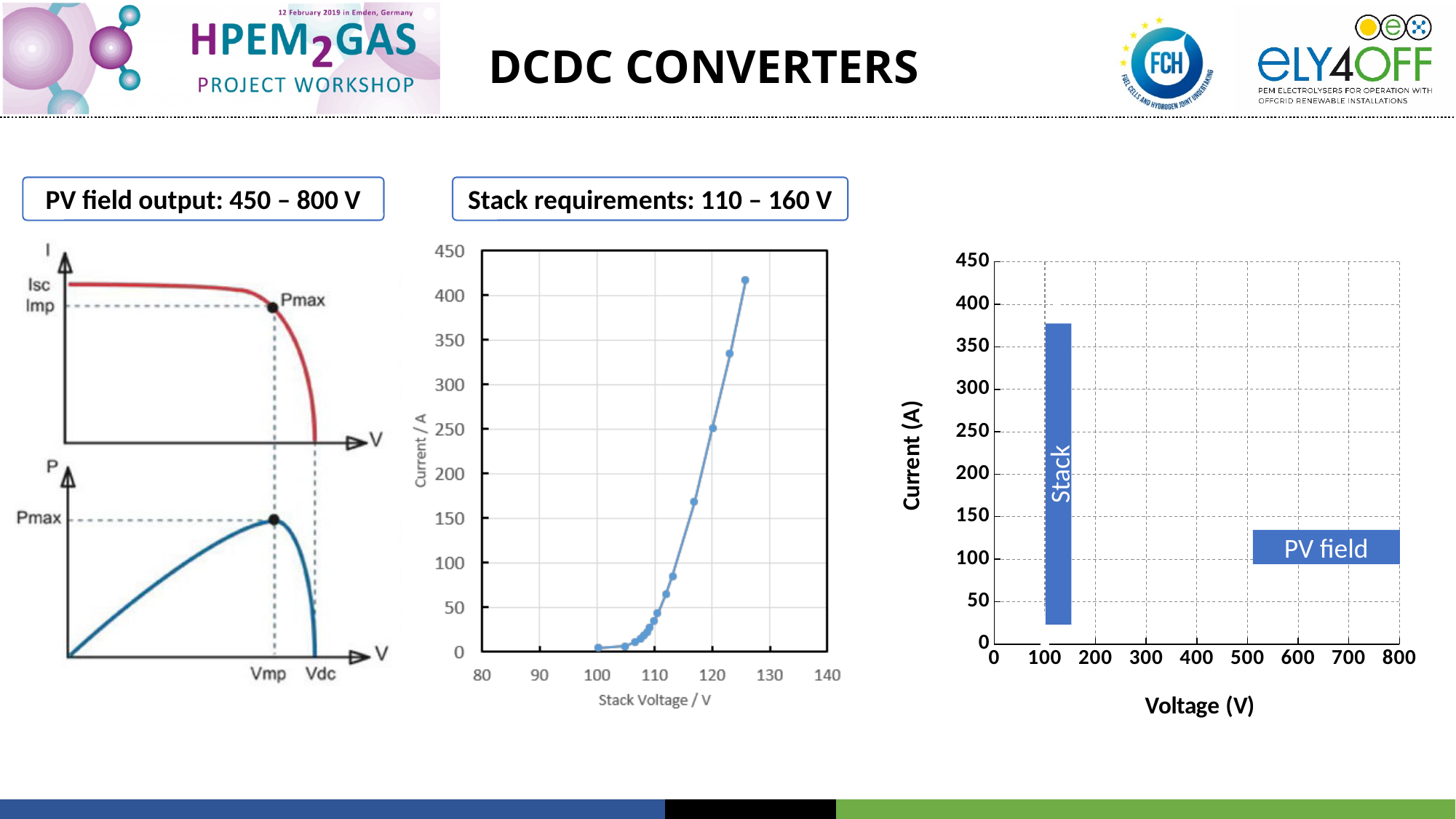
In the middle chart of stack current versus stack voltage, what is the label of the x axis? Stack Voltage / V In the middle chart of stack current versus stack voltage, what is the highest value shown on the y axis? 450 In the right-hand chart of current versus voltage, which region lies at the higher voltage, Stack or PV field? PV field In the right-hand chart of current versus voltage, which region reaches the higher current, Stack or PV field? Stack In the middle chart of stack current versus stack voltage, is the current at a stack voltage of 110 V greater or less than 50 A? less In the middle chart of stack current versus stack voltage, does the current rise or fall as the stack voltage increases? rise In the right-hand chart of current versus voltage, is the top of the PV field region greater or less than 150 A? less In the right-hand chart of current versus voltage, is the top of the Stack region greater or less than 350 A? greater In the middle chart of stack current versus stack voltage, what is the label of the y axis? Current / A In the right-hand chart of current versus voltage, how many operating regions are plotted? 2